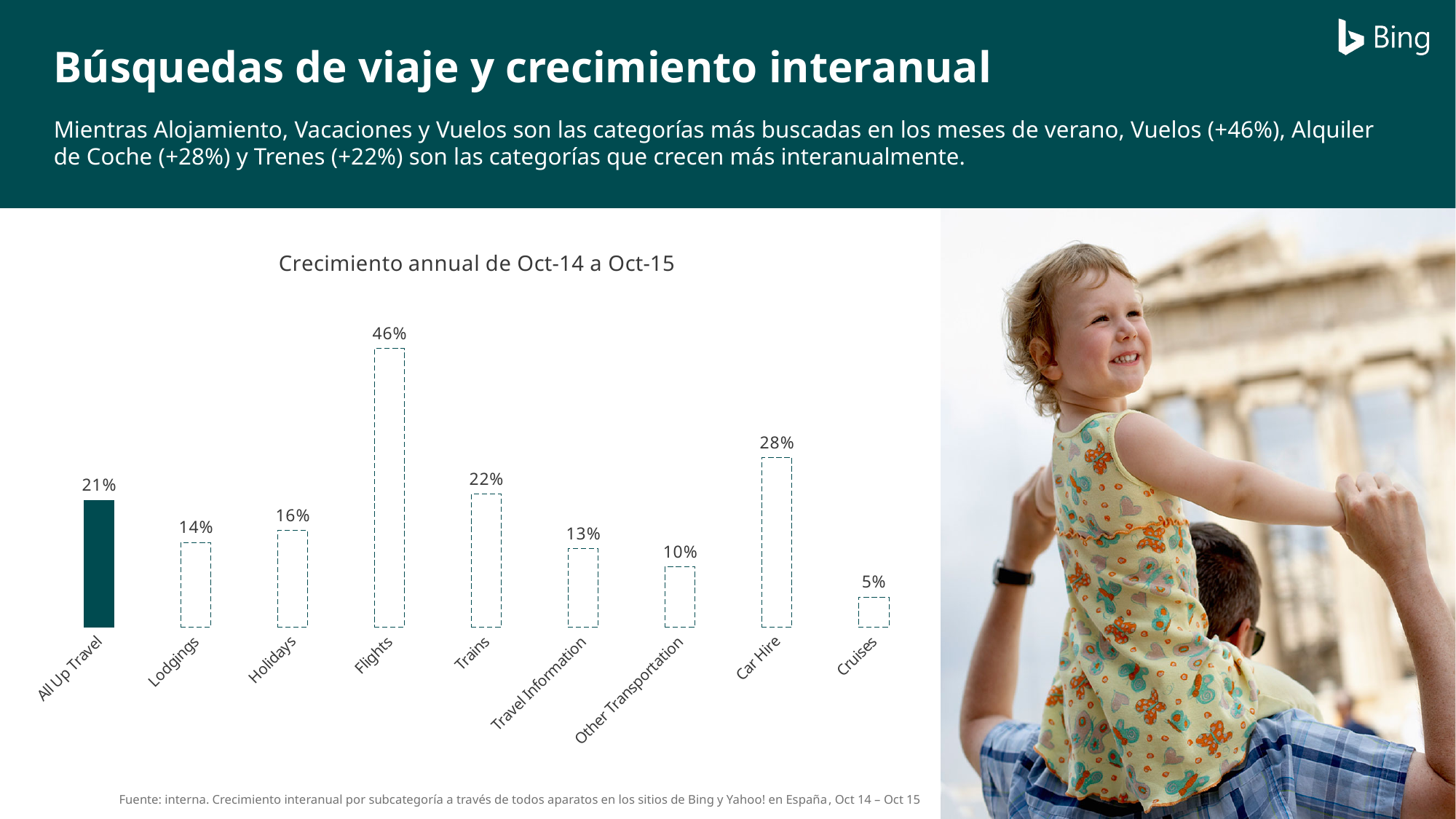
What kind of chart is shown on the slide? Bar chart Which category has the lowest growth? Cruises Which category has the highest growth? Flights Which is larger, the value for Holidays or the value for Lodgings? Holidays What is the value for Car Hire? 28% What is the value for Cruises? 5% What is the difference between the values for Flights and Car Hire? 18% What is the value for Flights? 46% What is the difference between the values for Trains and Travel Information? 9% How many categories are shown in the chart? 9 What is the title of the chart? Crecimiento annual de Oct-14 a Oct-15 What is the value for All Up Travel? 21%